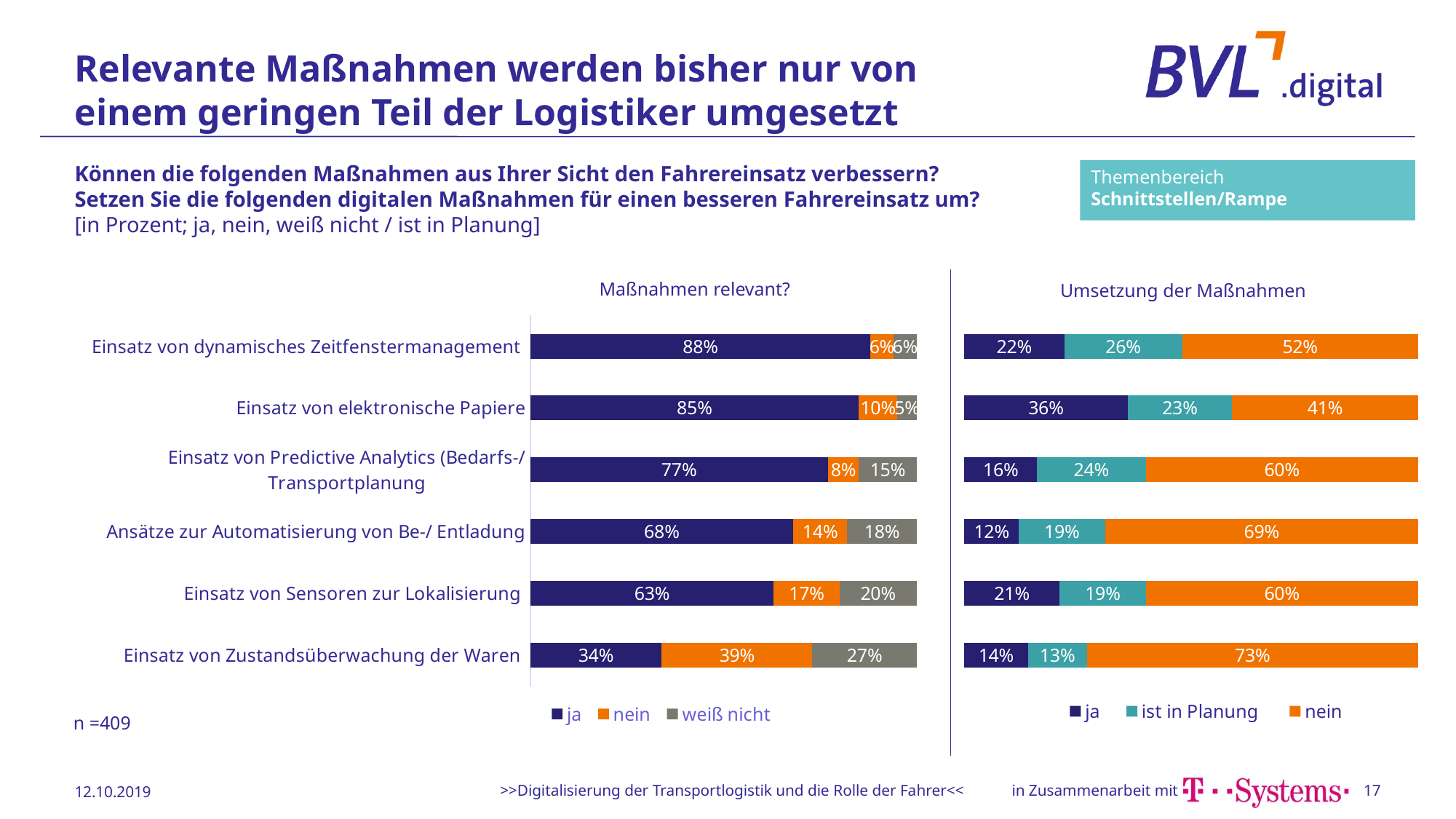
In the 'Umsetzung der Maßnahmen' chart, which is larger: the 'nein' value for 'Ansätze zur Automatisierung von Be-/ Entladung' or for 'Einsatz von Sensoren zur Lokalisierung'? Ansätze zur Automatisierung von Be-/ Entladung In the 'Umsetzung der Maßnahmen' chart, what is the 'nein' value for 'Einsatz von Zustandsüberwachung der Waren'? 73% How many series does the legend of the 'Umsetzung der Maßnahmen' chart list? 3 In the 'Maßnahmen relevant?' chart, what is the difference between the 'ja' values for 'Einsatz von Predictive Analytics (Bedarfs-/ Transportplanung' and 'Einsatz von Sensoren zur Lokalisierung'? 14% In the 'Umsetzung der Maßnahmen' chart, what is the 'ist in Planung' value for 'Einsatz von elektronische Papiere'? 23% How many categories are shown in the 'Maßnahmen relevant?' chart? 6 What kind of chart is the 'Umsetzung der Maßnahmen' chart? Stacked bar chart In the 'Maßnahmen relevant?' chart, what is the 'weiß nicht' value for 'Ansätze zur Automatisierung von Be-/ Entladung'? 18% In the 'Maßnahmen relevant?' chart, what is the 'ja' value for 'Einsatz von dynamisches Zeitfenstermanagement'? 88% In the 'Maßnahmen relevant?' chart, which category has the lowest 'ja' value? Einsatz von Zustandsüberwachung der Waren In the 'Umsetzung der Maßnahmen' chart, which category has the highest 'ja' value? Einsatz von elektronische Papiere What are the legend entries of the 'Maßnahmen relevant?' chart? ja, nein, weiß nicht